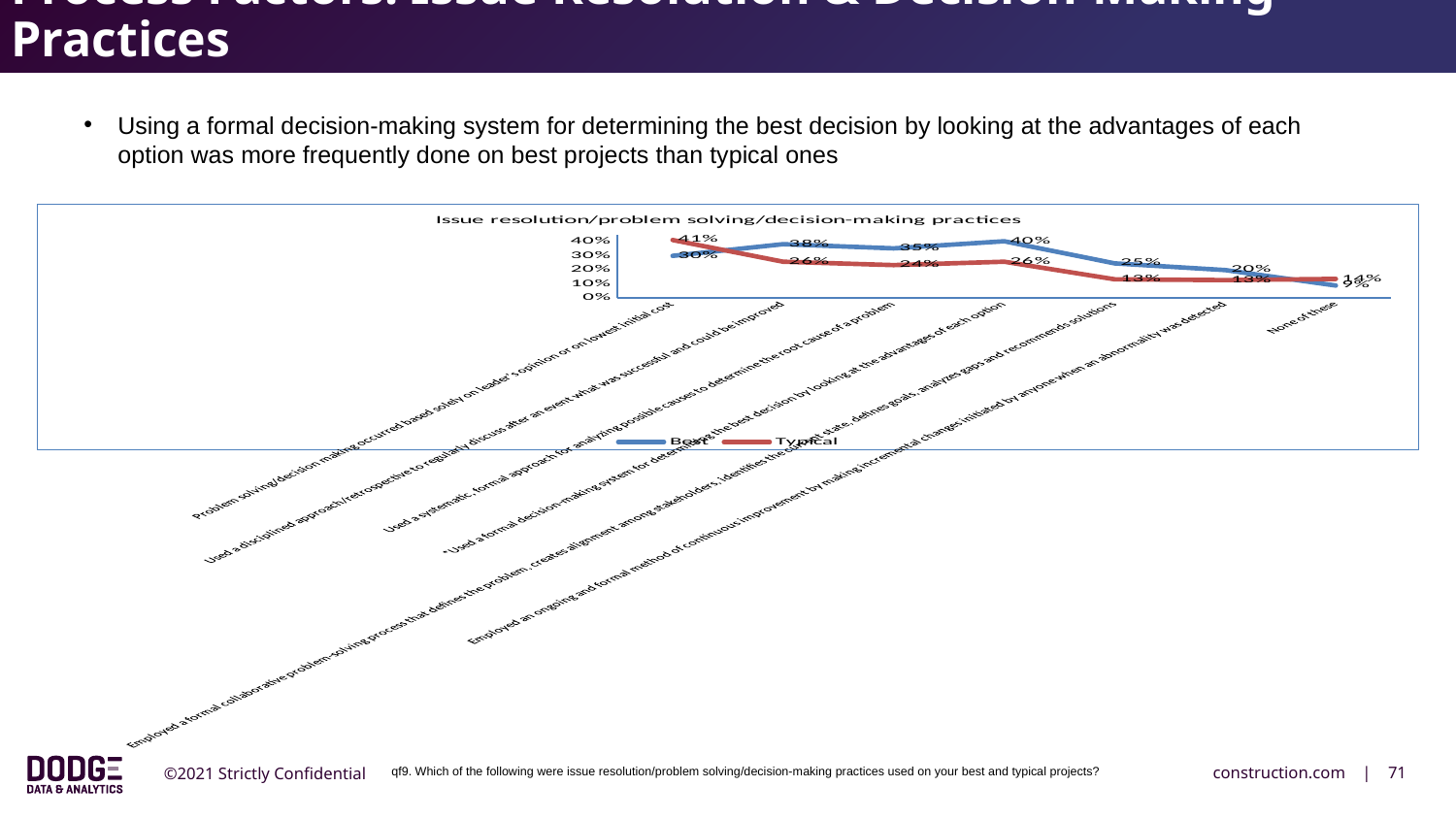
How many series does the chart legend list? 2 What is the difference between the Best and Typical values for 'Used a formal decision-making system for determining the best decision by looking at the advantages of each option'? 14 percentage points What is the Typical value for 'Used a systematic, formal approach for analyzing possible causes to determine the root cause of a problem'? 24% What is the Best value for 'Used a formal decision-making system for determining the best decision by looking at the advantages of each option'? 40% What are the two series named in the chart legend? Best and Typical Which practice has the highest Typical value? Problem solving/decision making occurred based solely on leader's opinion or on lowest initial cost What is the Best value for 'Used a disciplined approach/retrospective to regularly discuss after an event what was successful and could be improved'? 38% What is the Typical value for 'Problem solving/decision making occurred based solely on leader's opinion or on lowest initial cost'? 41% What kind of chart is shown on the slide? line chart For 'Problem solving/decision making occurred based solely on leader's opinion or on lowest initial cost', which series has the larger value, Best or Typical? Typical What is the title of the chart? Issue resolution/problem solving/decision-making practices What is the Typical value for 'Employed a formal collaborative problem-solving process that defines the problem, creates alignment among stakeholders, identifies the current state, defines goals, analyzes gaps and recommends solutions'? 13%